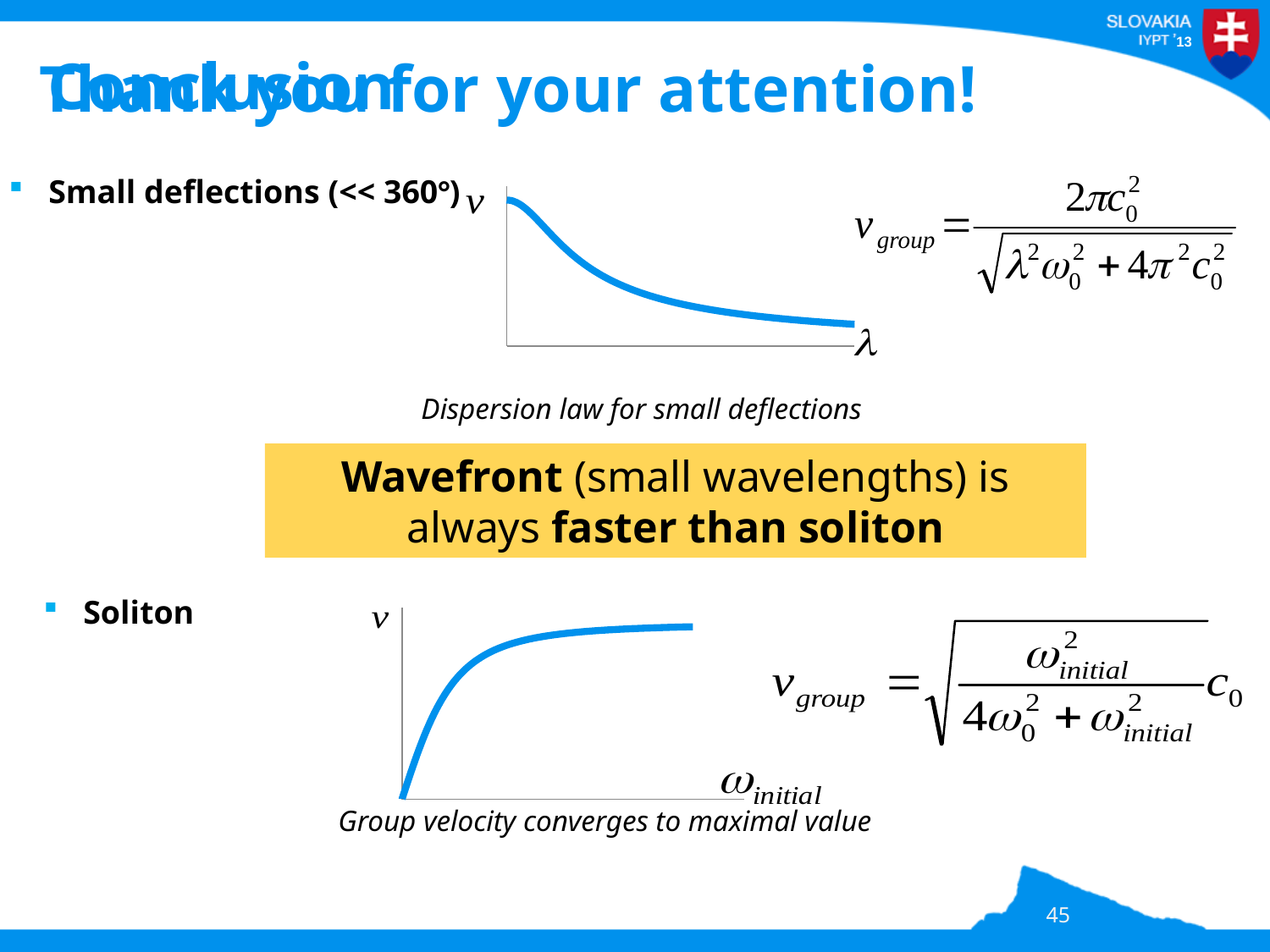
What kind of chart is the one captioned "Dispersion law for small deflections"? line chart In the chart captioned "Dispersion law for small deflections", what is the label on the horizontal axis? λ How many curves are plotted in the chart captioned "Group velocity converges to maximal value"? 1 What kind of chart is the one captioned "Group velocity converges to maximal value"? line chart In the chart captioned "Group velocity converges to maximal value", does the plotted value rise or fall as ω_initial increases along the x axis? rise In the chart captioned "Group velocity converges to maximal value", what is the label on the horizontal axis? ω_initial How many charts are shown on the slide? 2 In the chart captioned "Dispersion law for small deflections", does the plotted value rise or fall as λ increases along the x axis? fall